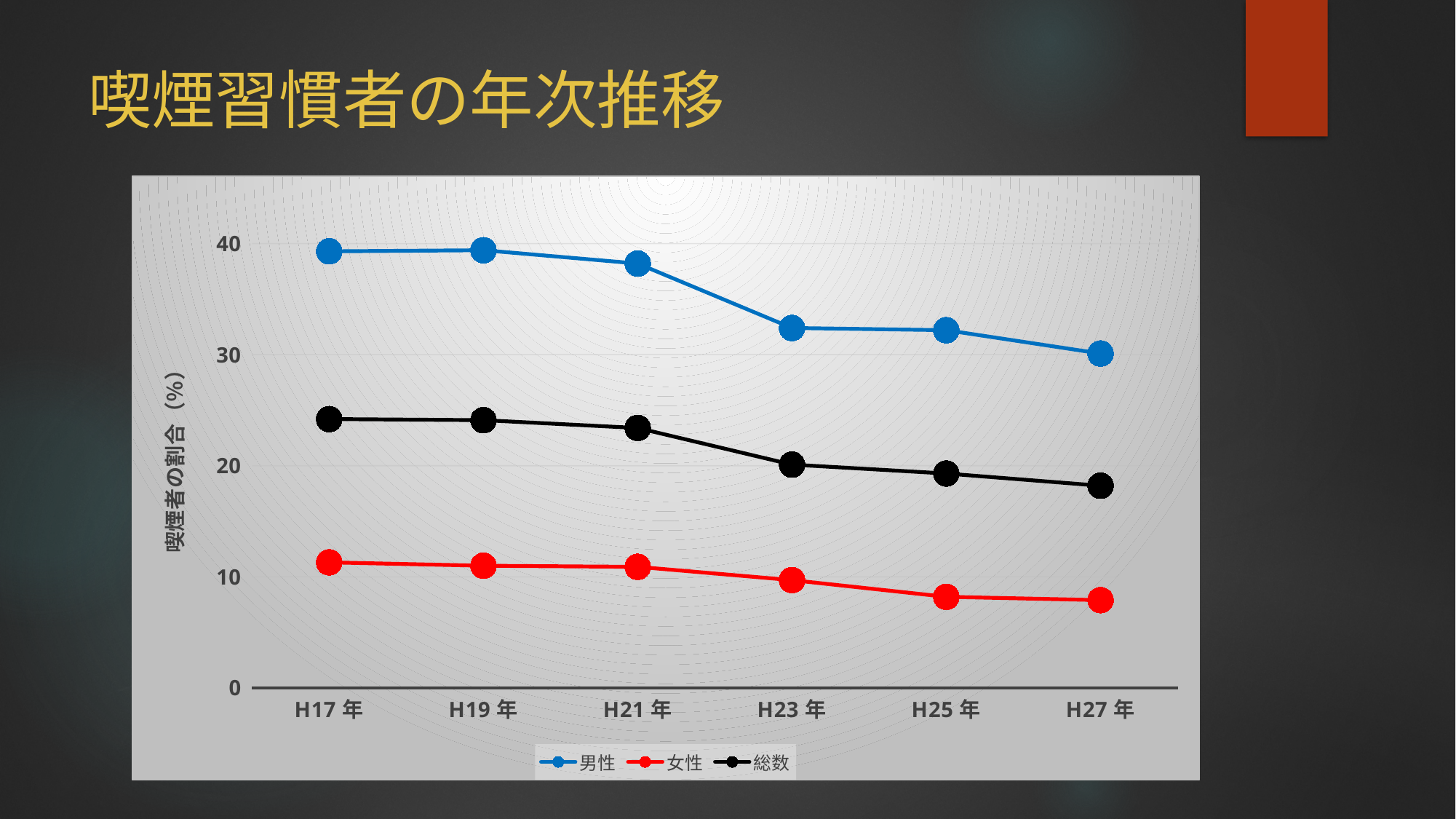
How many years are plotted along the x axis? 6 Is the value for 女性 in H27年 greater or less than 10? less Which series has the highest values throughout the chart? 男性 Is the value for 男性 in H17年 greater or less than 30? greater What kind of chart is shown on the slide? line chart Which is larger, the value for 男性 in H21年 or the value for 男性 in H23年? H21年 Do the values for 男性 rise or fall from H17年 to H27年? fall How many series does the legend list? 3 What is the title of the chart on the slide? 喫煙習慣者の年次推移 Is the value for 総数 in H27年 greater or less than 20? less Do the values for 総数 rise or fall from H17年 to H27年? fall Which series has the lowest values throughout the chart? 女性